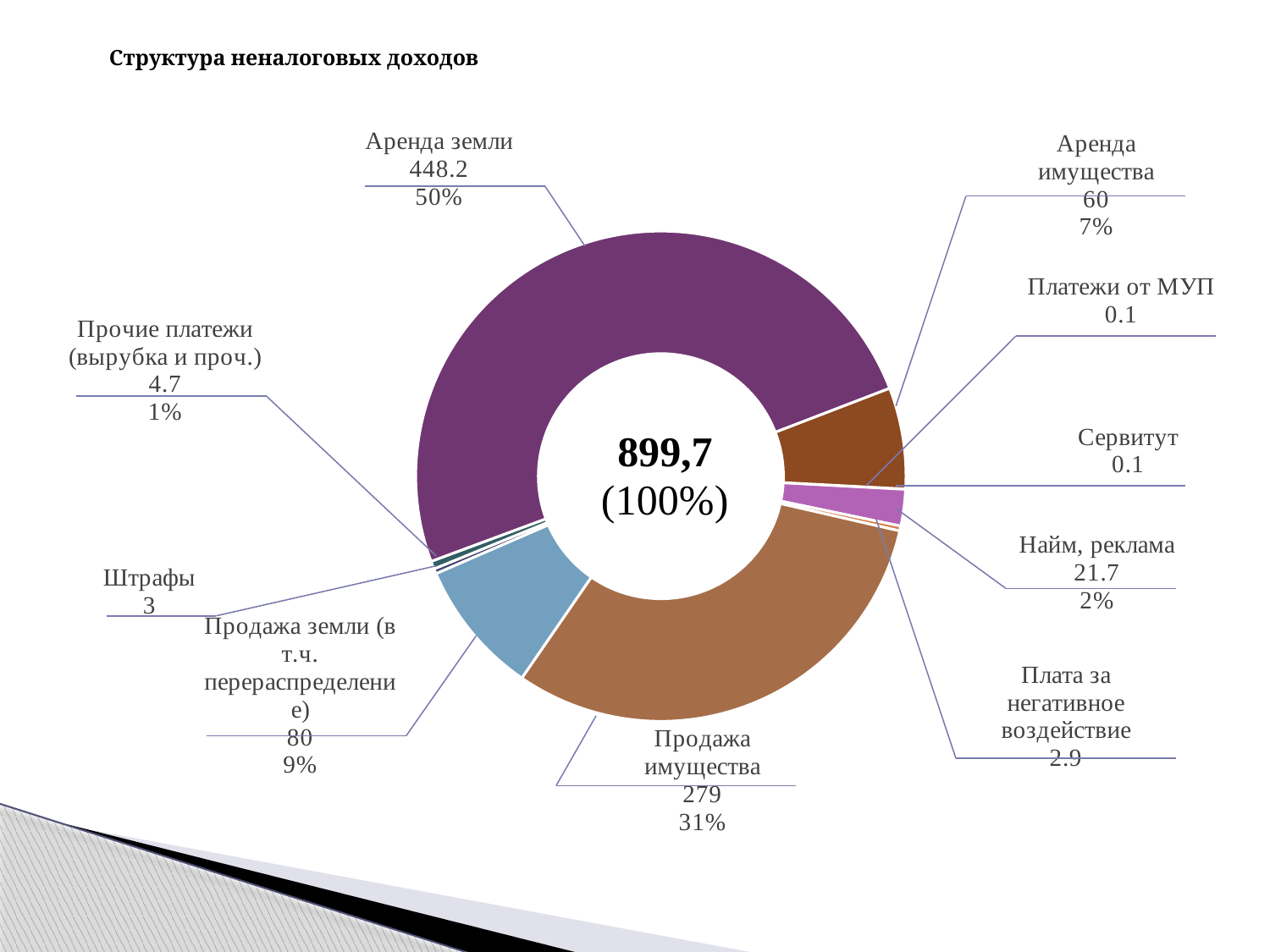
What is the value for Найм, реклама? 21.7 What is the difference between the values for Аренда земли and Продажа имущества? 169.2 Which is larger, the value for Аренда имущества or the value for Продажа земли (в т.ч. перераспределение)? Продажа земли (в т.ч. перераспределение) What is the value for Аренда земли? 448.2 How many categories are shown in the chart? 10 What kind of chart is shown on the slide? Doughnut chart What is the value for Плата за негативное воздействие? 2.9 What share of the chart does Продажа имущества represent? 31% What total value is shown in the centre of the chart? 899,7 What is the value for Продажа имущества? 279 Which category has the largest share of the chart? Аренда земли What share of the chart does Аренда имущества represent? 7%